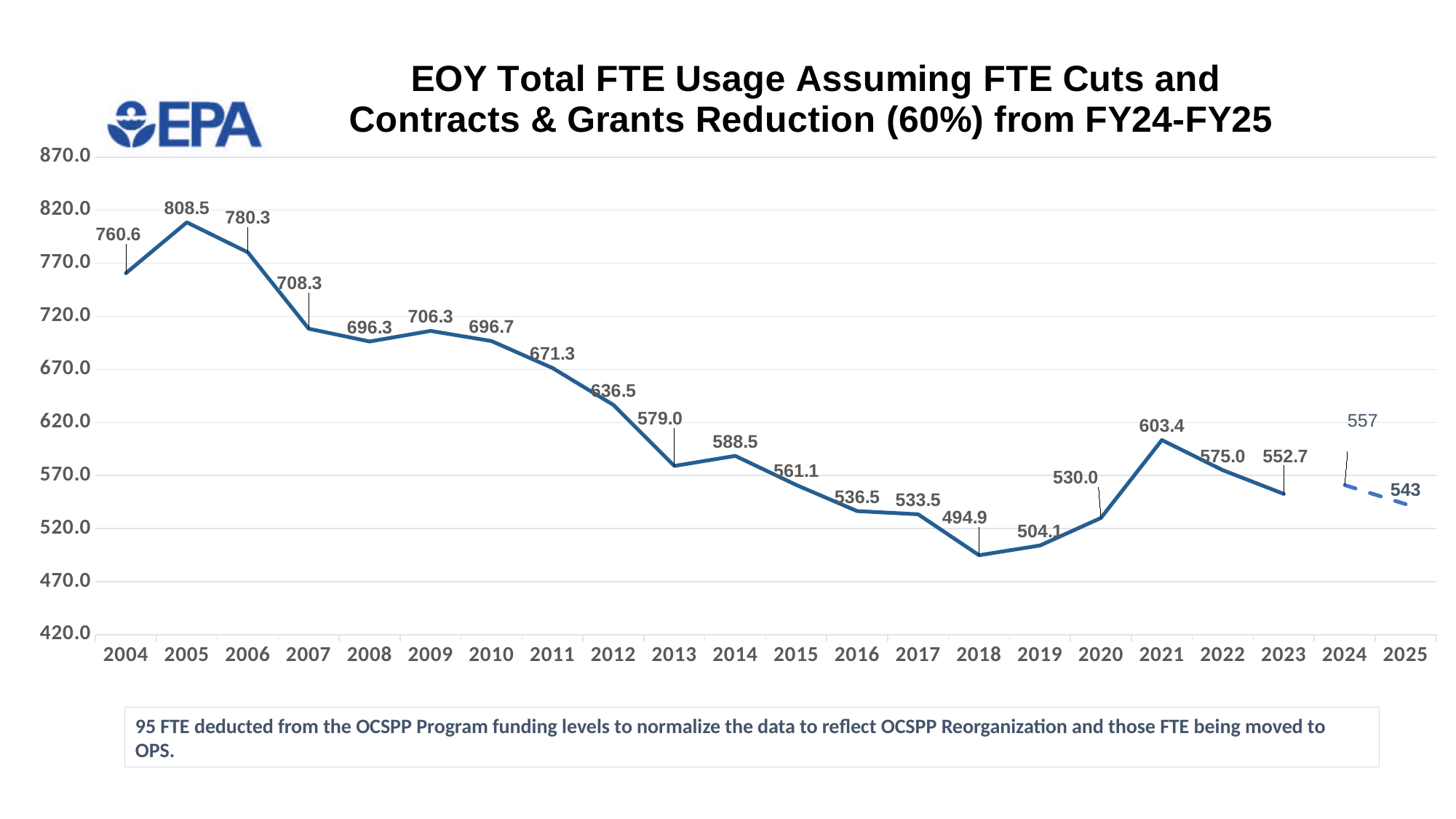
What type of chart is shown on the slide? Line chart What is the EOY total FTE usage value for 2005? 808.5 Which year has the larger value, 2013 or 2014? 2014 By how much did the value increase from 2020 to 2021? 73.4 What is the difference between the 2005 value and the 2004 value? 47.9 Overall, do the values rise or fall from 2004 to 2025? Fall Which year has the highest FTE usage value? 2005 Is the value for 2012 greater or less than 620.0? greater What is the projected value shown for 2025? 543 Which year has the lowest FTE usage value? 2018 What is the value shown for 2018? 494.9 How many years are plotted on the x axis? 22